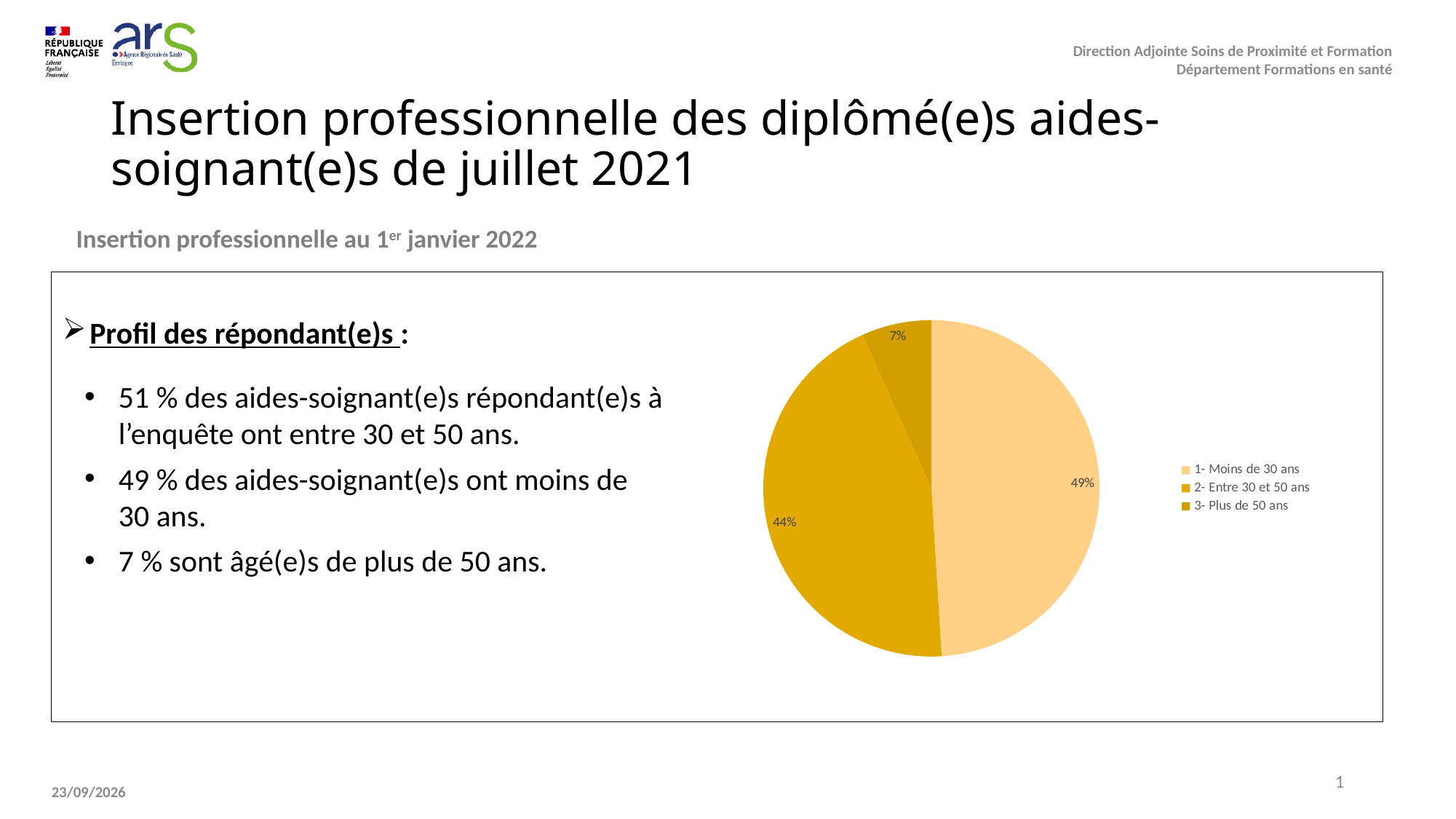
Which slice is larger: "2- Entre 30 et 50 ans" or "3- Plus de 50 ans"? 2- Entre 30 et 50 ans What share of the pie is labelled for "2- Entre 30 et 50 ans"? 44% Which category has the smallest slice of the pie? 3- Plus de 50 ans What is the difference in percentage points between the "1- Moins de 30 ans" slice and the "2- Entre 30 et 50 ans" slice? 5 What share of the pie is labelled for "1- Moins de 30 ans"? 49% How many categories does the pie chart have? 3 How many entries does the legend of the pie chart list? 3 What share of the pie is labelled for "3- Plus de 50 ans"? 7% What kind of chart is shown on the slide? Pie chart What is the difference in percentage points between the "2- Entre 30 et 50 ans" slice and the "3- Plus de 50 ans" slice? 37 Which category has the largest slice of the pie? 1- Moins de 30 ans Which legend entry is shown in the lightest colour? 1- Moins de 30 ans